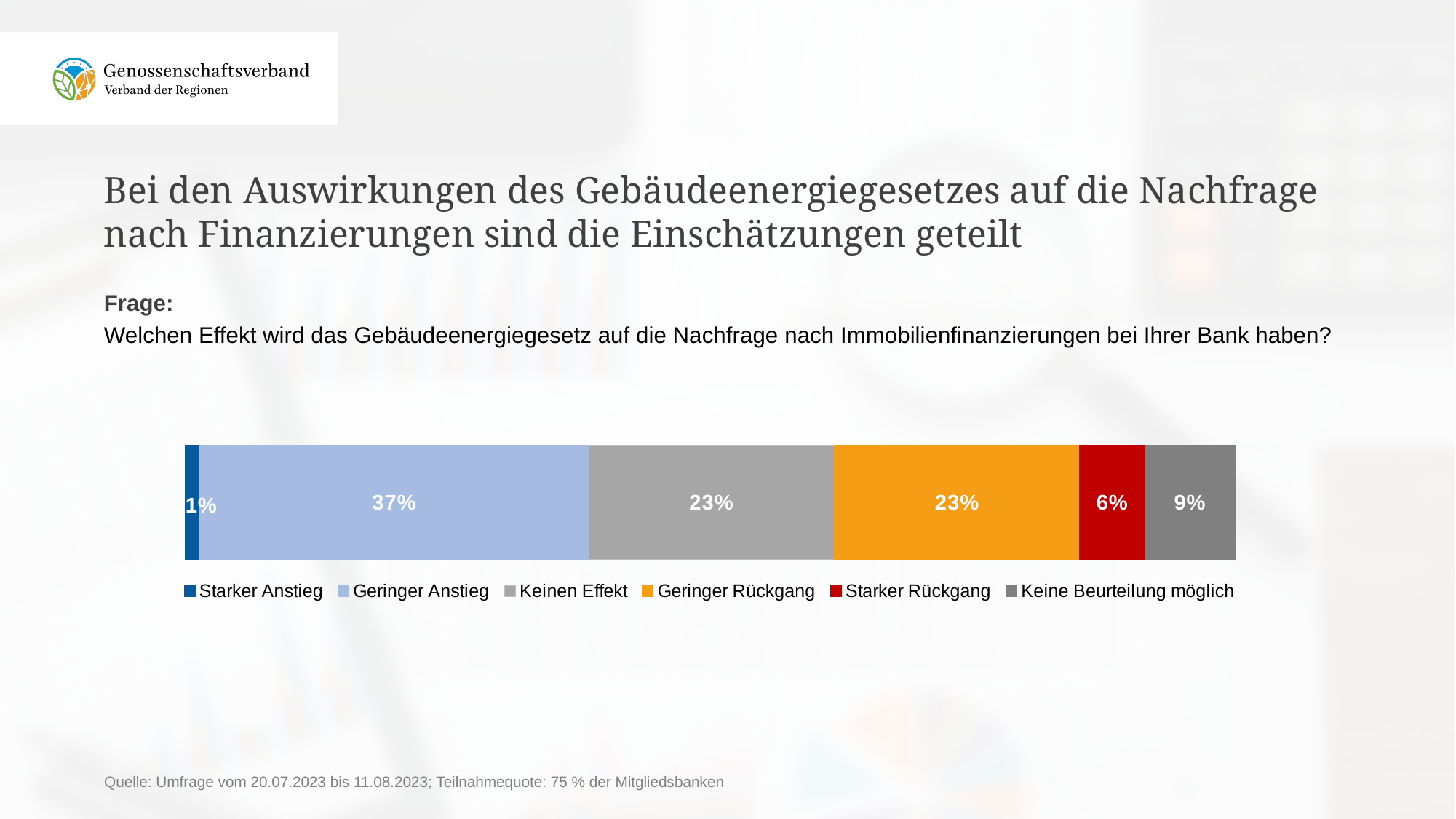
What is the difference in percentage points between 'Geringer Anstieg' and 'Keinen Effekt'? 14 Which response category has the lowest share? Starker Anstieg What kind of chart is shown on the slide? Stacked bar chart How many response categories does the legend list? 6 Which colour represents 'Geringer Rückgang' in the chart? Orange What share of respondents answered 'Keine Beurteilung möglich'? 9% What is the combined share of 'Geringer Rückgang' and 'Starker Rückgang'? 29% What percentage of respondents expect a 'Geringer Anstieg' (slight increase)? 37% Which is larger, the share for 'Starker Rückgang' or for 'Keine Beurteilung möglich'? Keine Beurteilung möglich What is the value shown for 'Starker Rückgang'? 6% What is the value for 'Starker Anstieg'? 1% Which response category has the highest share? Geringer Anstieg